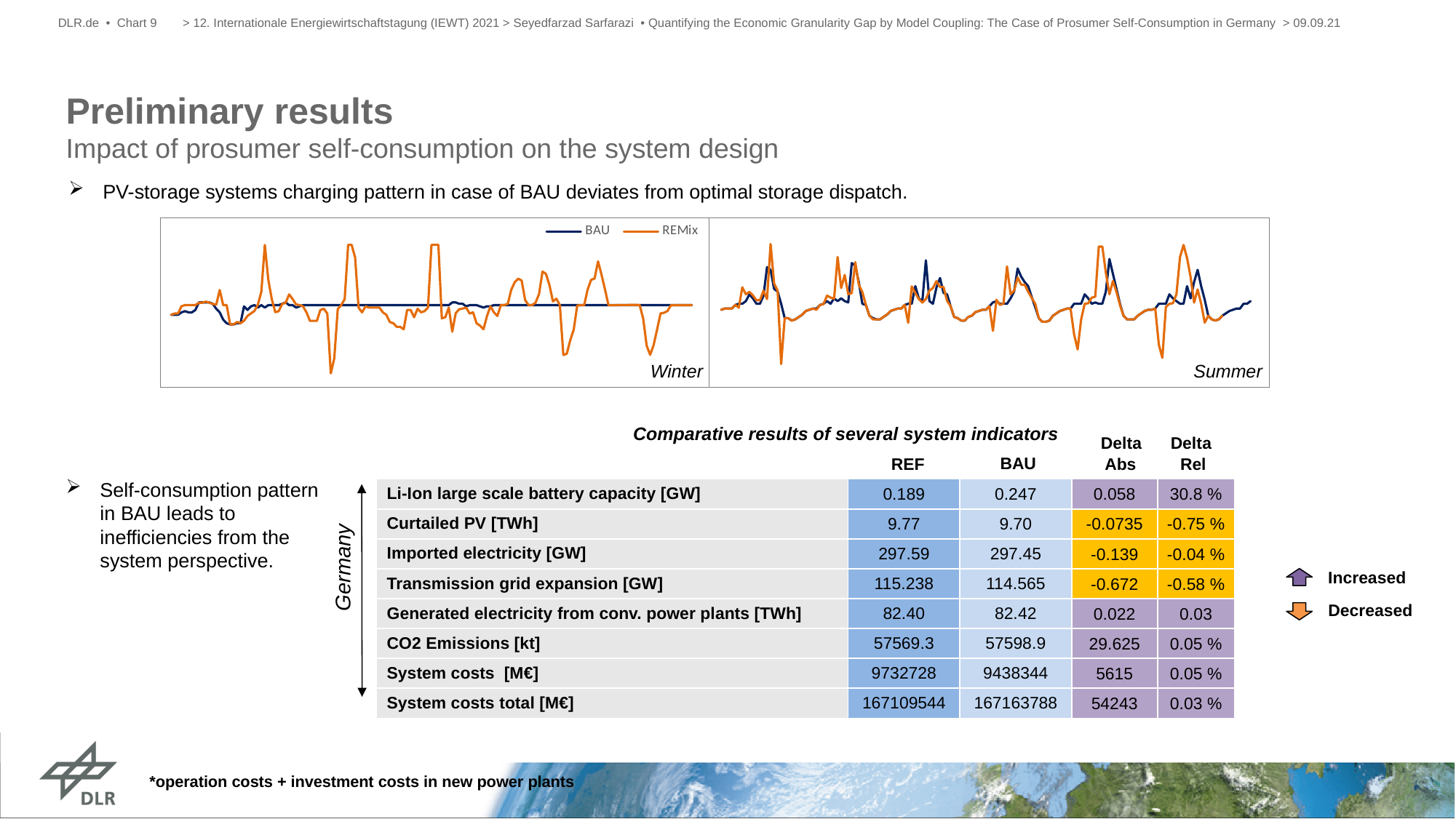
Which two series are listed in the legend of the Winter chart? BAU and REMix In the Winter chart, which series shows larger fluctuations, BAU or REMix? REMix How many series does the legend of the Winter chart list? 2 What kind of chart is the Summer chart? line chart In the Winter chart, which colour is used for the REMix series? orange What kind of chart is the Winter chart? line chart In the Winter chart, which series stays nearly flat for most of the period, BAU or REMix? BAU